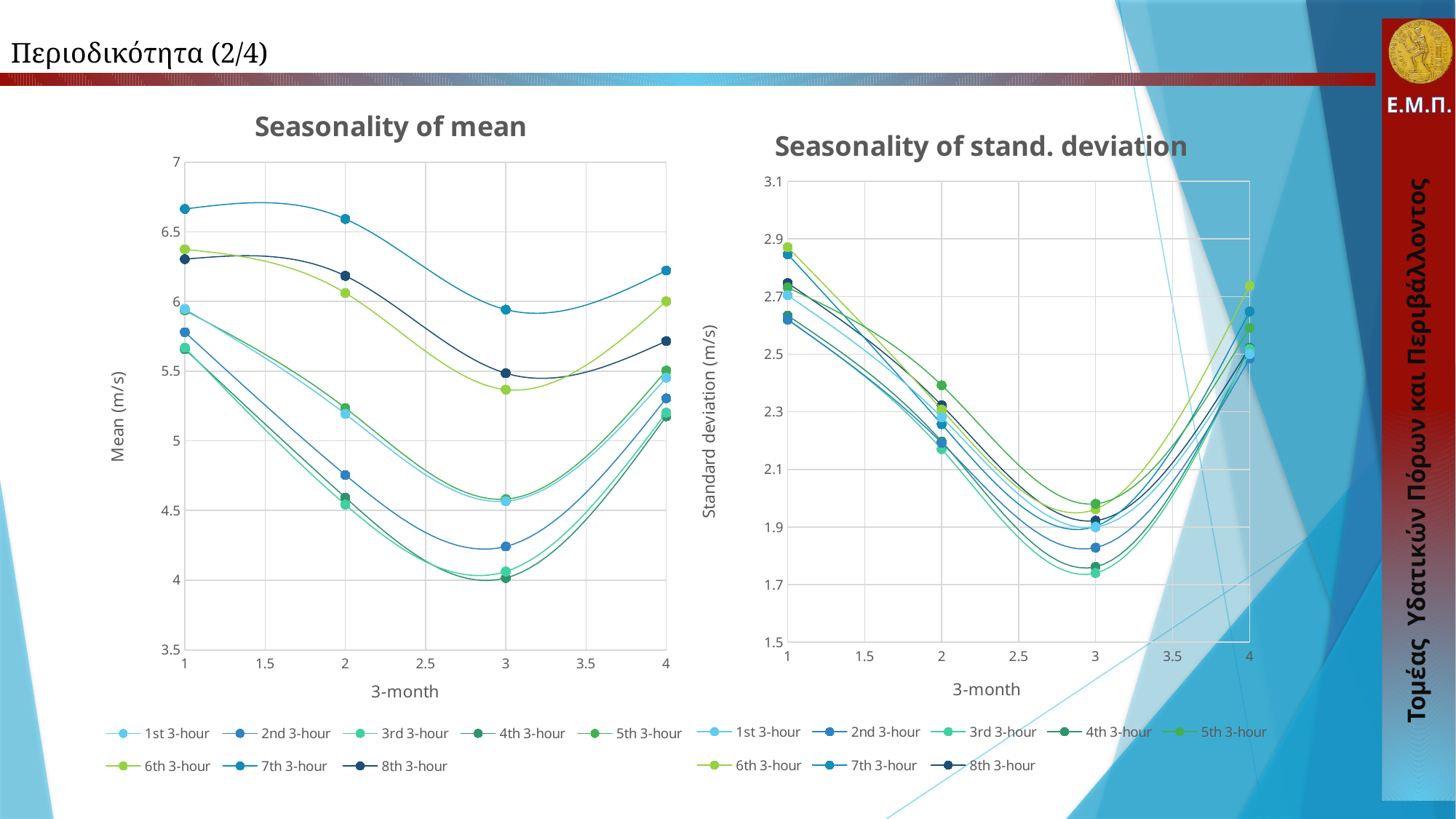
In the 'Seasonality of mean' chart, which series has the highest value at 3-month 1? 7th 3-hour In the 'Seasonality of mean' chart, how many 3-month points are plotted for each series? 4 In the 'Seasonality of stand. deviation' chart, is the value of the 1st 3-hour series at 3-month 1 greater or less than 2.5? greater In the 'Seasonality of mean' chart, is the value of the 2nd 3-hour series at 3-month 3 greater or less than 4.5? less How many series does the legend of the 'Seasonality of stand. deviation' chart list? 8 What is the y-axis label of the 'Seasonality of stand. deviation' chart? Standard deviation (m/s) In the 'Seasonality of stand. deviation' chart, do the values of the 7th 3-hour series rise or fall from 3-month 1 to 3-month 3? fall What type of chart is the 'Seasonality of mean' chart? line chart In the 'Seasonality of stand. deviation' chart, is the value of the 2nd 3-hour series at 3-month 3 greater or less than 1.9? less In the 'Seasonality of mean' chart, which series has the highest value at 3-month 3? 7th 3-hour What is the x-axis label of the 'Seasonality of mean' chart? 3-month